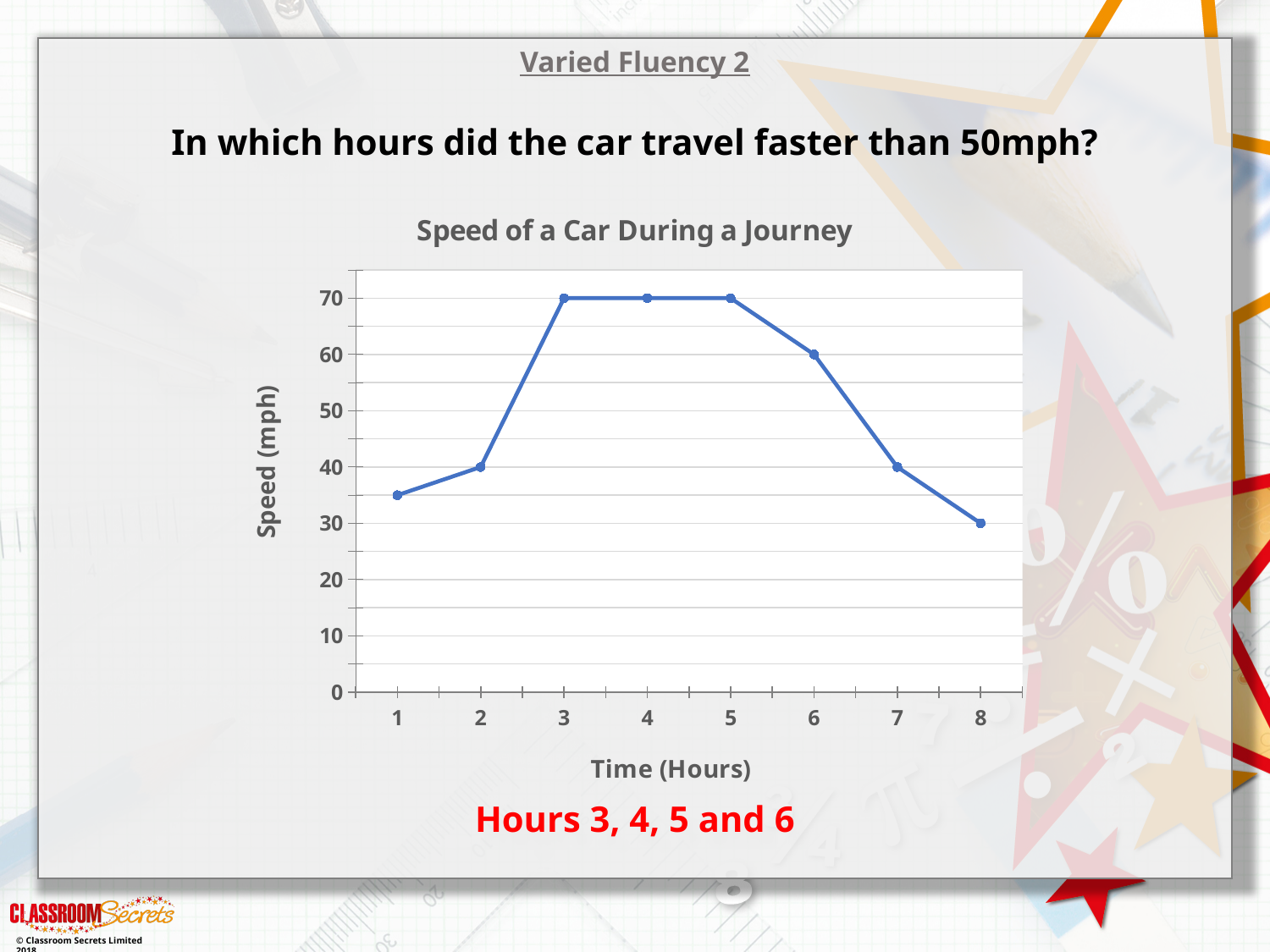
Is the speed at hour 1 greater or less than 50? less How many hours are plotted on the x axis? 8 What is the speed of the car at hour 8? 30 What is the difference in speed between hour 5 and hour 7? 30 What is the speed of the car at hour 4? 70 Is the speed at hour 6 greater or less than 50? greater What is the speed of the car at hour 6? 60 What kind of chart is shown on the slide? line chart What is the title of the chart? Speed of a Car During a Journey What is the speed of the car at hour 2? 40 Does the speed rise or fall between hour 5 and hour 8? fall At which hour is the car's speed lowest? 8